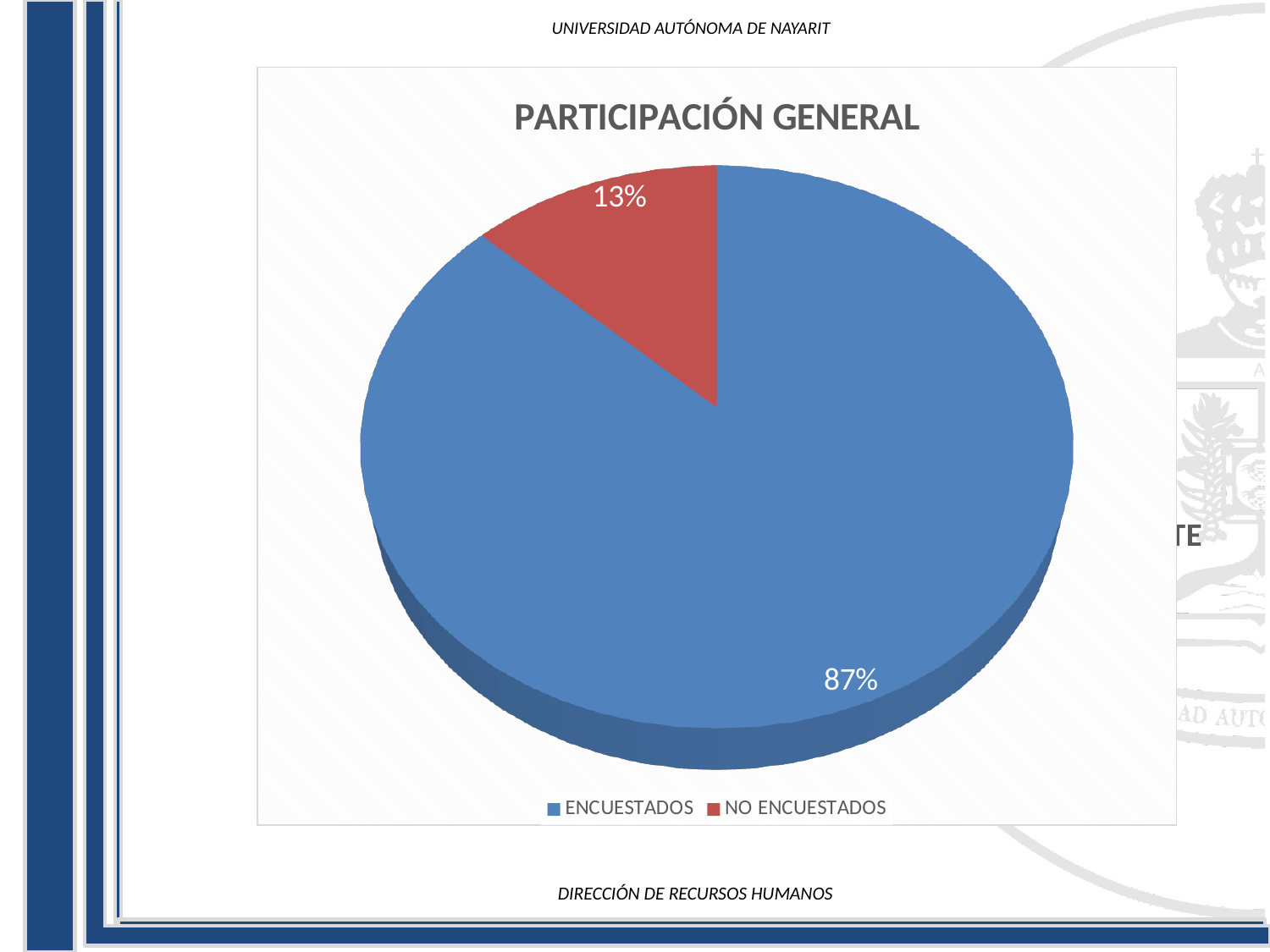
What share of the pie does NO ENCUESTADOS represent? 13% Which category has the largest slice of the pie? ENCUESTADOS How many entries does the legend list? 2 What colour is the slice for NO ENCUESTADOS? red Which category has the smallest slice of the pie? NO ENCUESTADOS What is the difference in percentage points between ENCUESTADOS and NO ENCUESTADOS? 74 How many categories does the pie chart show? 2 What kind of chart is shown on the slide? pie chart What is the title of the chart? PARTICIPACIÓN GENERAL What share of the pie does ENCUESTADOS represent? 87% Which is larger, the share for ENCUESTADOS or the share for NO ENCUESTADOS? ENCUESTADOS